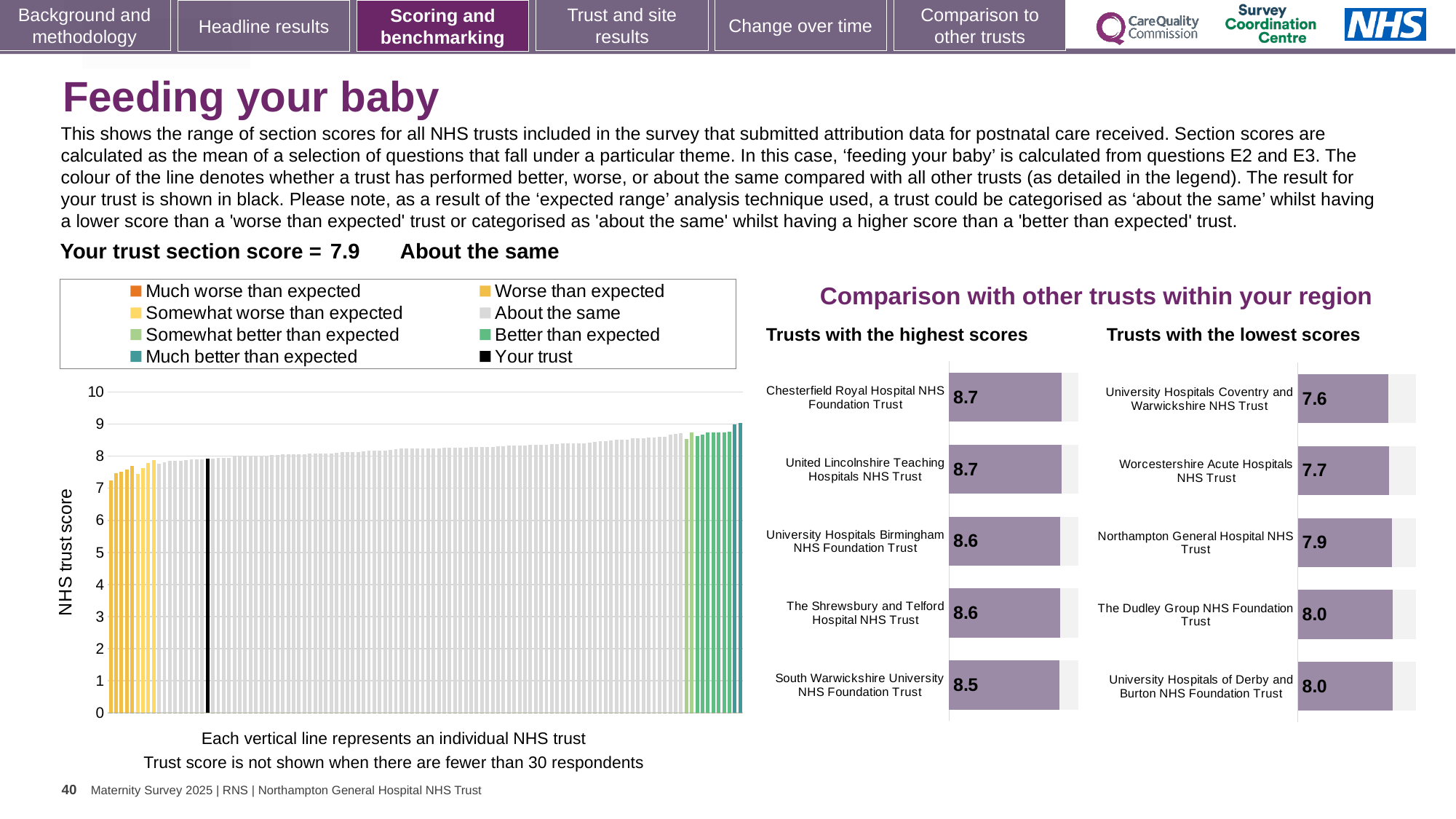
In the 'Trusts with the highest scores' chart, what is the score for Chesterfield Royal Hospital NHS Foundation Trust? 8.7 In the 'Trusts with the lowest scores' chart, what is the score for Northampton General Hospital NHS Trust? 7.9 What kind of chart is the large chart on the left showing NHS trust scores? bar chart How many entries does the legend above the large chart on the left list? 8 In the 'Trusts with the highest scores' chart, which trust has the lowest score? South Warwickshire University NHS Foundation Trust In the 'Trusts with the lowest scores' chart, which trust has the lowest score? University Hospitals Coventry and Warwickshire NHS Trust In the large chart on the left, what is the label on the vertical axis? NHS trust score In the large chart on the left, do the bar values rise or fall from left to right? rise In the 'Trusts with the highest scores' chart, how many trusts are shown? 5 In the 'Trusts with the lowest scores' chart, which has the higher score: Worcestershire Acute Hospitals NHS Trust or Northampton General Hospital NHS Trust? Northampton General Hospital NHS Trust In the 'Trusts with the lowest scores' chart, what is the difference between the scores of University Hospitals of Derby and Burton NHS Foundation Trust and University Hospitals Coventry and Warwickshire NHS Trust? 0.4 In the 'Trusts with the highest scores' chart, what is the score for South Warwickshire University NHS Foundation Trust? 8.5